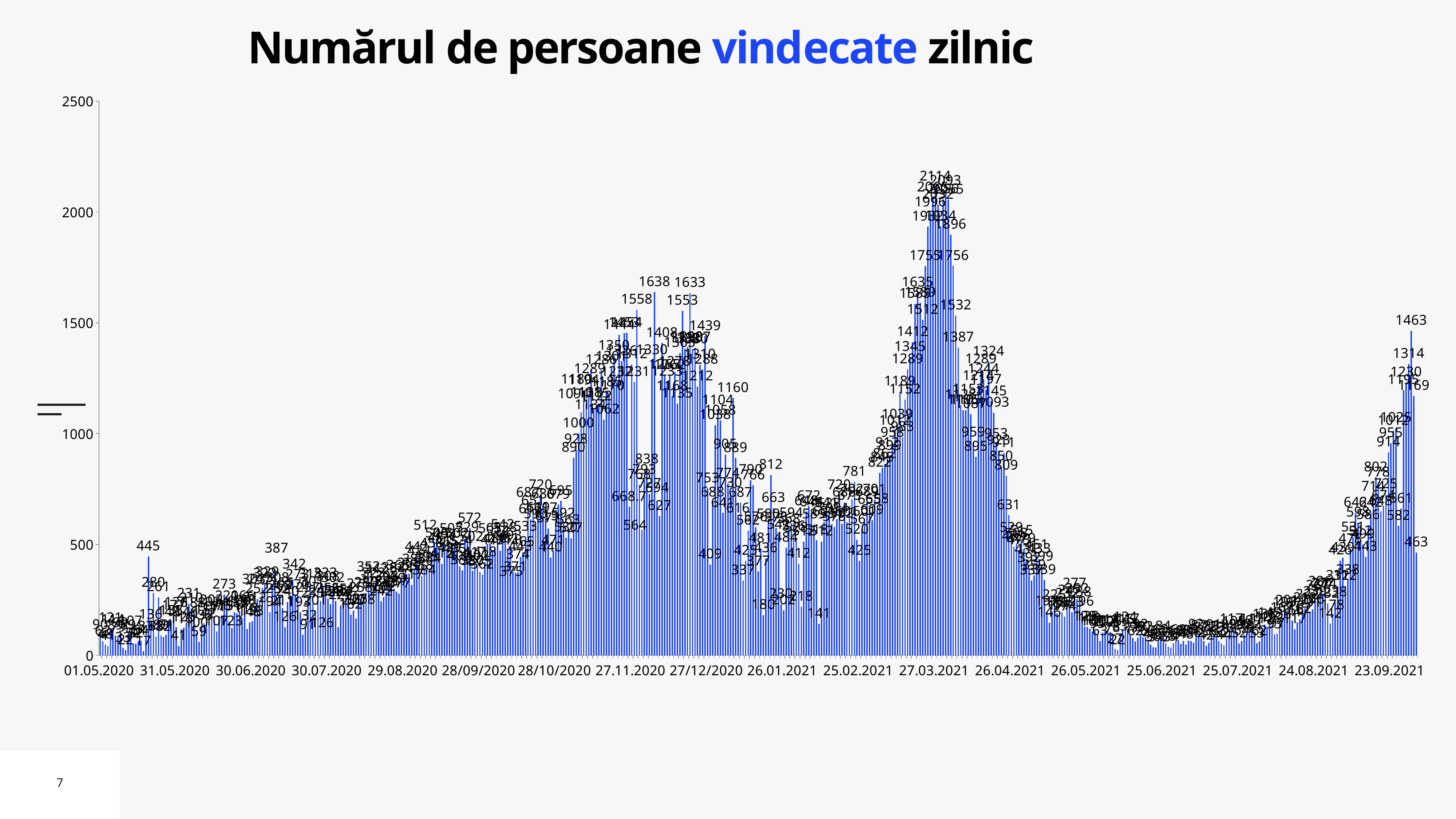
What kind of chart is shown on the slide? bar chart What is the difference between the highest label of the peak around 27.03.2021 (2114) and the highest label of the peak around 27.11.2020 (1638)? 476 What is the title of the chart? Numărul de persoane vindecate zilnic Is the peak value around 27.03.2021 greater or less than 2000? greater Are the values for the first bars at 01.05.2020 greater or less than 500? less What is the highest labeled value in the peak around 27.11.2020? 1638 Do the values rise or fall between 26.04.2021 and 26.05.2021? fall What is the highest data label shown on the chart? 2114 Do the values rise or fall between 24.08.2021 and 23.09.2021? rise Which peak is higher: the one around 27.03.2021 or the one around 27.11.2020? 27.03.2021 What is the highest labeled value in the rise near 23.09.2021? 1463 What is the value labeled on the last (rightmost) bar of the chart? 463